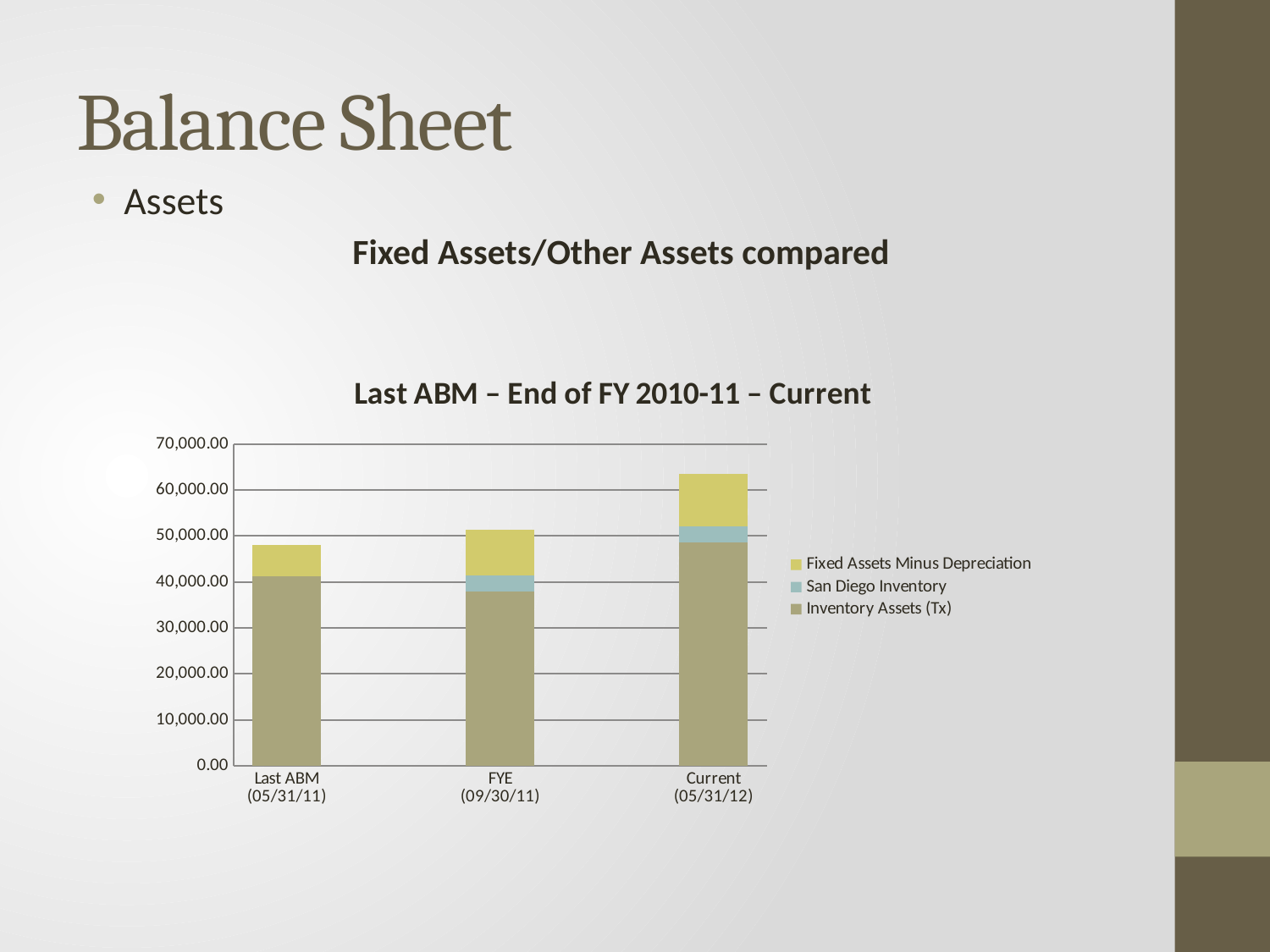
Is the Inventory Assets (Tx) value for Current (05/31/12) greater or less than 50,000.00? less What kind of chart is shown on the slide? Stacked bar chart Which has the larger total stacked value, Last ABM (05/31/11) or Current (05/31/12)? Current (05/31/12) Is the total stacked value for Last ABM (05/31/11) greater or less than 50,000.00? less Is the Inventory Assets (Tx) value for FYE (09/30/11) greater or less than 40,000.00? less Which category has the shortest stacked bar? Last ABM (05/31/11) Do the total stacked values rise or fall from Last ABM (05/31/11) to Current (05/31/12)? Rise Which category has the tallest stacked bar? Current (05/31/12) What is the title of the chart? Last ABM – End of FY 2010-11 – Current How many series does the chart's legend list? 3 How many categories are shown on the x axis of the chart? 3